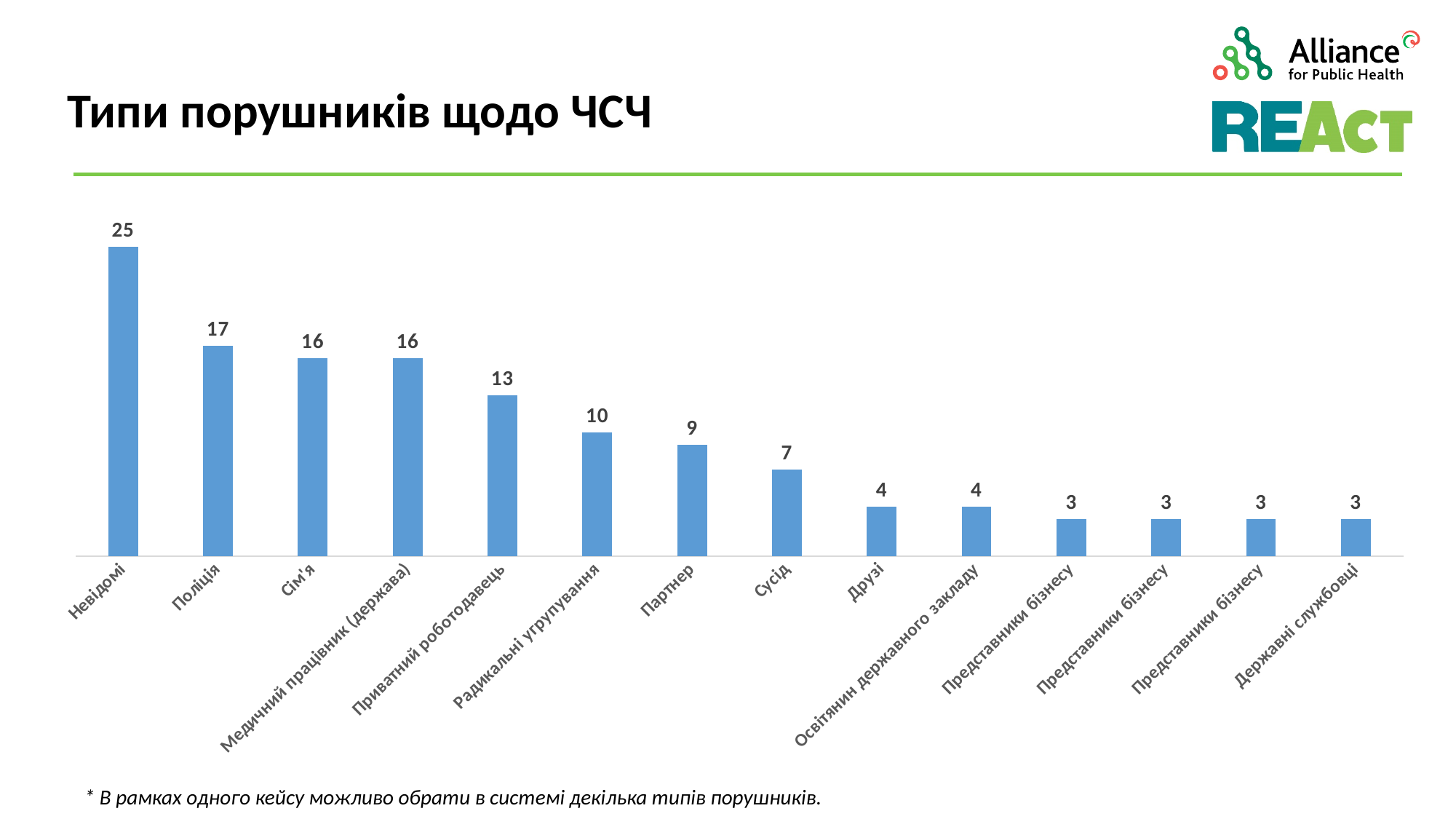
What is the value for Невідомі? 25 What is the value for Державні службовці? 3 What is the value for Сусід? 7 What type of chart is shown on the slide? Bar chart What is the value for Поліція? 17 What is the value for Радикальні угрупування? 10 What is the difference between the values for Невідомі and Поліція? 8 What is the value for Приватний роботодавець? 13 Which is larger, the value for Партнер or the value for Сусід? Партнер What is the title of the slide? Типи порушників щодо ЧСЧ How many bars are plotted in the chart? 14 Which category has the highest value? Невідомі